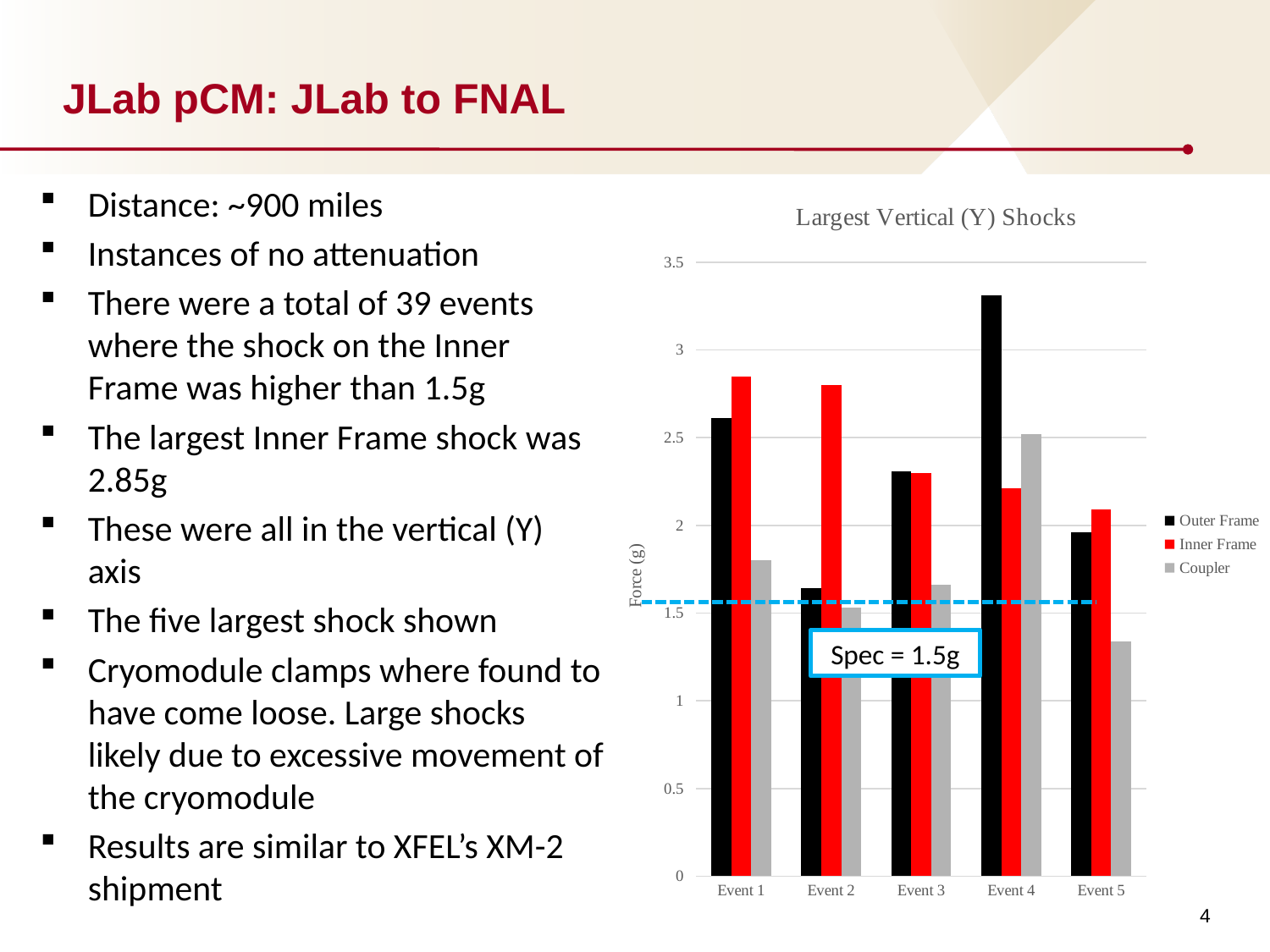
What is the label on the vertical axis of the chart? Force (g) Is the Inner Frame value for Event 2 greater or less than 2.5? greater What kind of chart is shown on the slide? bar chart Is the Coupler value for Event 5 greater or less than 1.5? less For which event is the Outer Frame value highest? Event 4 Is the Outer Frame value for Event 4 greater or less than 3? greater For Event 4, which is larger: the Outer Frame value or the Inner Frame value? Outer Frame What is the title of the chart? Largest Vertical (Y) Shocks For which event is the Coupler value lowest? Event 5 For Event 1, which is larger: the Inner Frame value or the Coupler value? Inner Frame How many series does the chart legend list? 3 How many events are shown along the x axis of the chart? 5